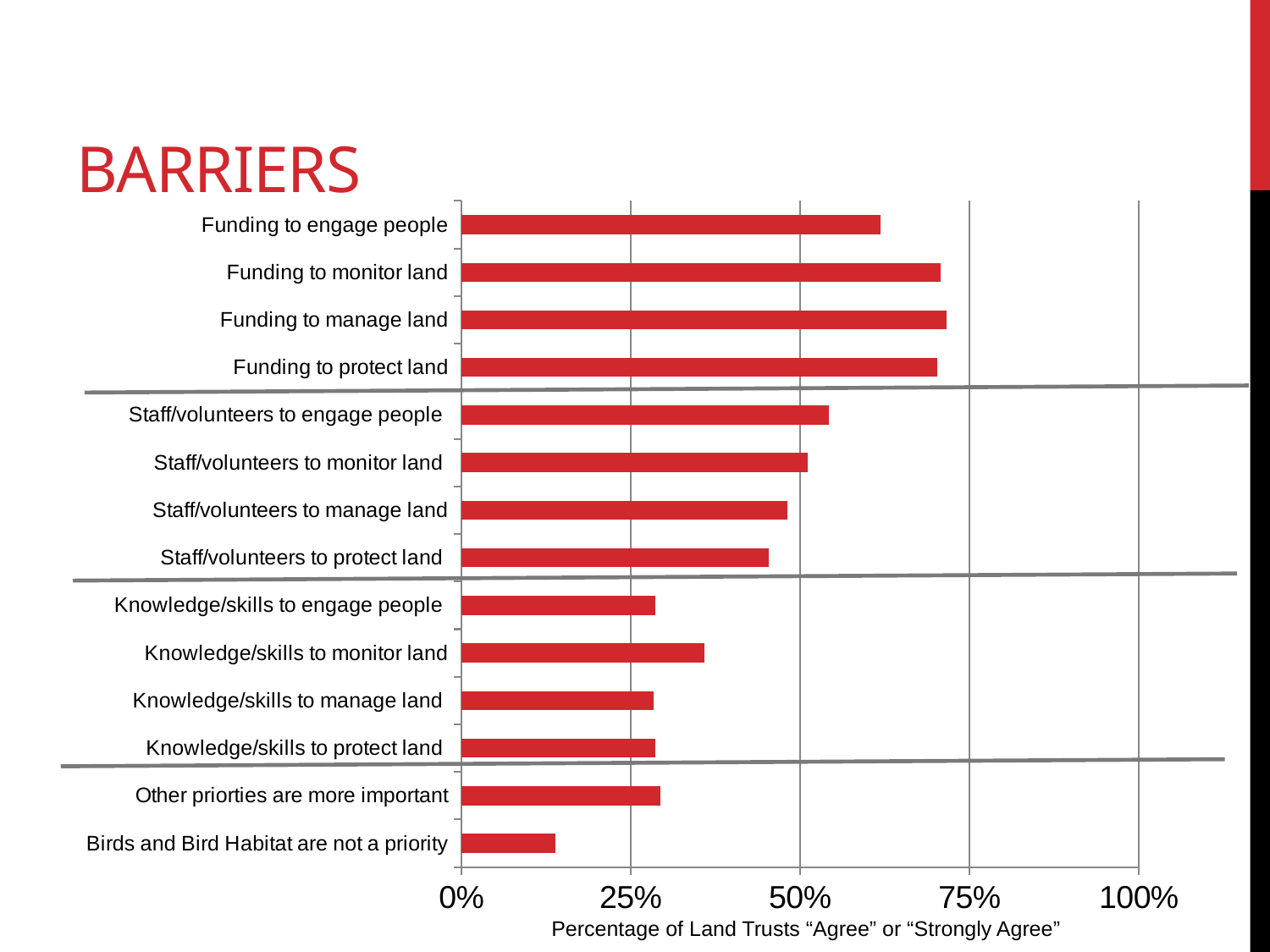
Which category has the lowest value? Birds and Bird Habitat are not a priority What is the label on the horizontal axis? Percentage of Land Trusts "Agree" or "Strongly Agree" Which is larger: Funding to engage people or Staff/volunteers to engage people? Funding to engage people Is the value for Birds and Bird Habitat are not a priority greater or less than 25%? less Is the value for Knowledge/skills to monitor land greater or less than 25%? greater Is the value for Staff/volunteers to protect land greater or less than 50%? less How many categories (bars) does the chart show? 14 What kind of chart is shown on the slide? Bar chart Which is larger: Knowledge/skills to monitor land or Knowledge/skills to manage land? Knowledge/skills to monitor land What is the title of the chart? BARRIERS